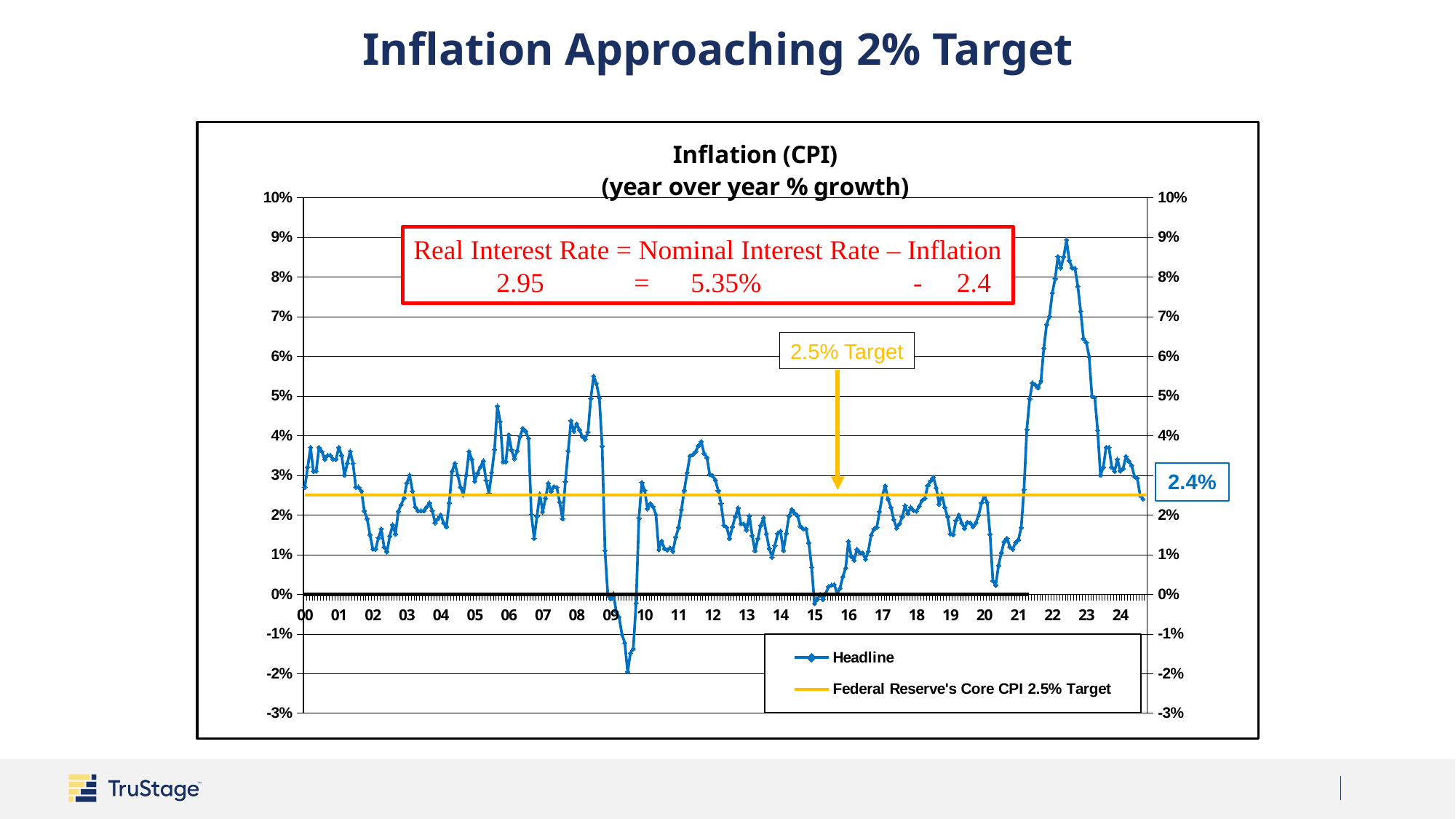
What kind of chart is shown on the slide? line chart From the 2022 peak to the end of 2024, do Headline values rise or fall? fall Which is higher: the Headline peak around 2008 or the Headline peak around 2022? 2022 Is the latest Headline value (2.4%) above or below the 2.5% target line? below In which year label does the Headline series reach its highest value? 22 Is the peak of the Headline series around 2022 greater or less than 8%? greater How many series does the legend list? 2 What is the title of the chart? Inflation (CPI) (year over year % growth) In which year label does the Headline series reach its lowest value? 09 Is the lowest point of the Headline series around 2009 greater or less than -1%? less At what level is the Federal Reserve's Core CPI target line drawn? 2.5% What is the most recent Headline inflation value labeled on the chart? 2.4%